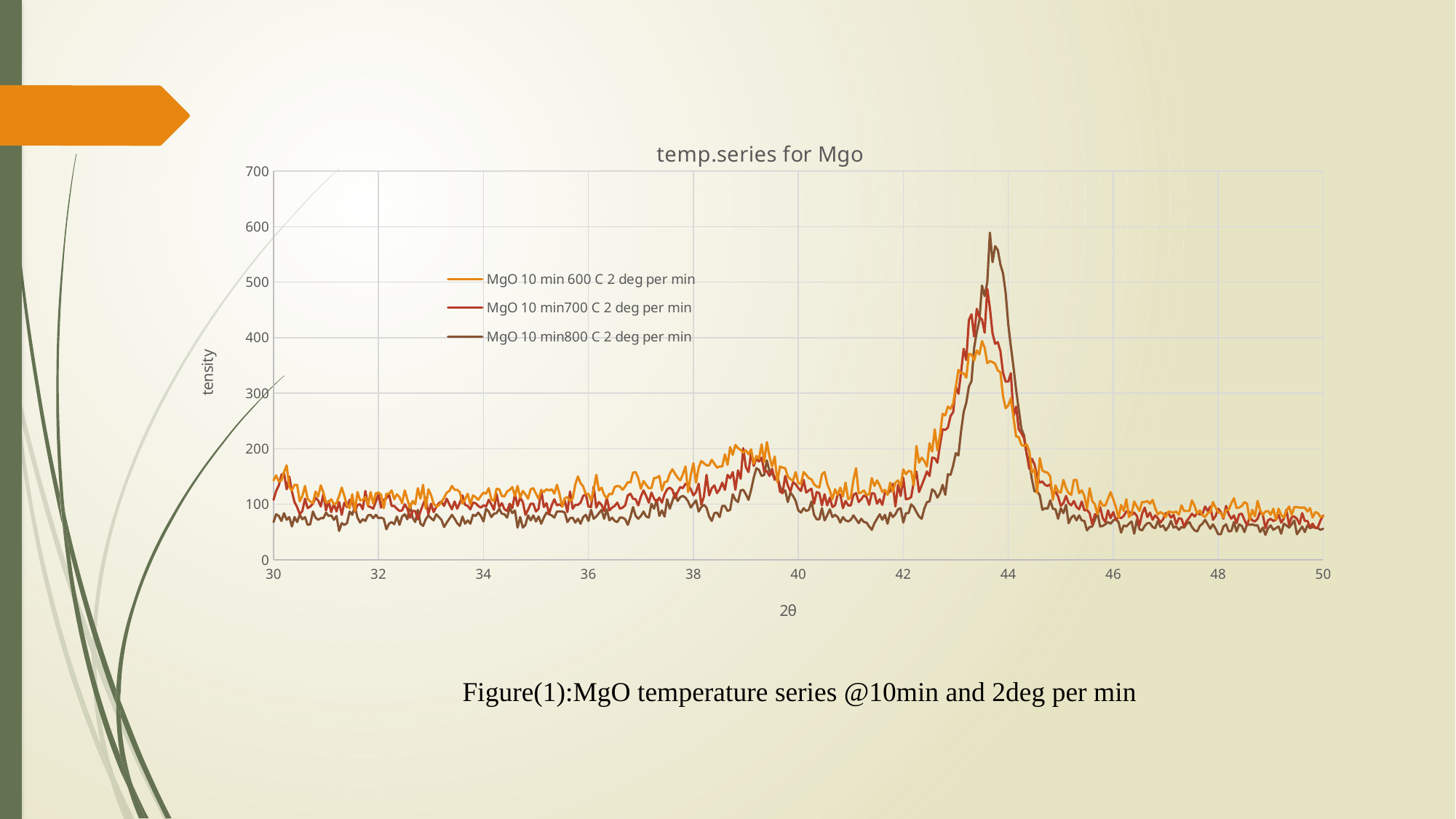
Is the peak value of the MgO 10 min 600 C 2 deg per min series greater or less than 500? less Do the intensity values rise or fall between 2θ = 44 and 2θ = 46? fall Is the peak value of the MgO 10 min700 C 2 deg per min series greater or less than 400? greater What is the label on the x axis of the chart? 2θ What kind of chart is shown on the slide? line chart Which series reaches the highest peak intensity? MgO 10 min800 C 2 deg per min At the main peak near 2θ = 44, which series is higher: MgO 10 min800 C 2 deg per min or MgO 10 min 600 C 2 deg per min? MgO 10 min800 C 2 deg per min How many series does the legend list? 3 What is the title of the chart? temp.series for Mgo Which series has the lowest baseline intensity between 2θ = 30 and 2θ = 38? MgO 10 min800 C 2 deg per min Is the peak value of the MgO 10 min800 C 2 deg per min series greater or less than 500? greater What is the highest value shown on the y axis? 700